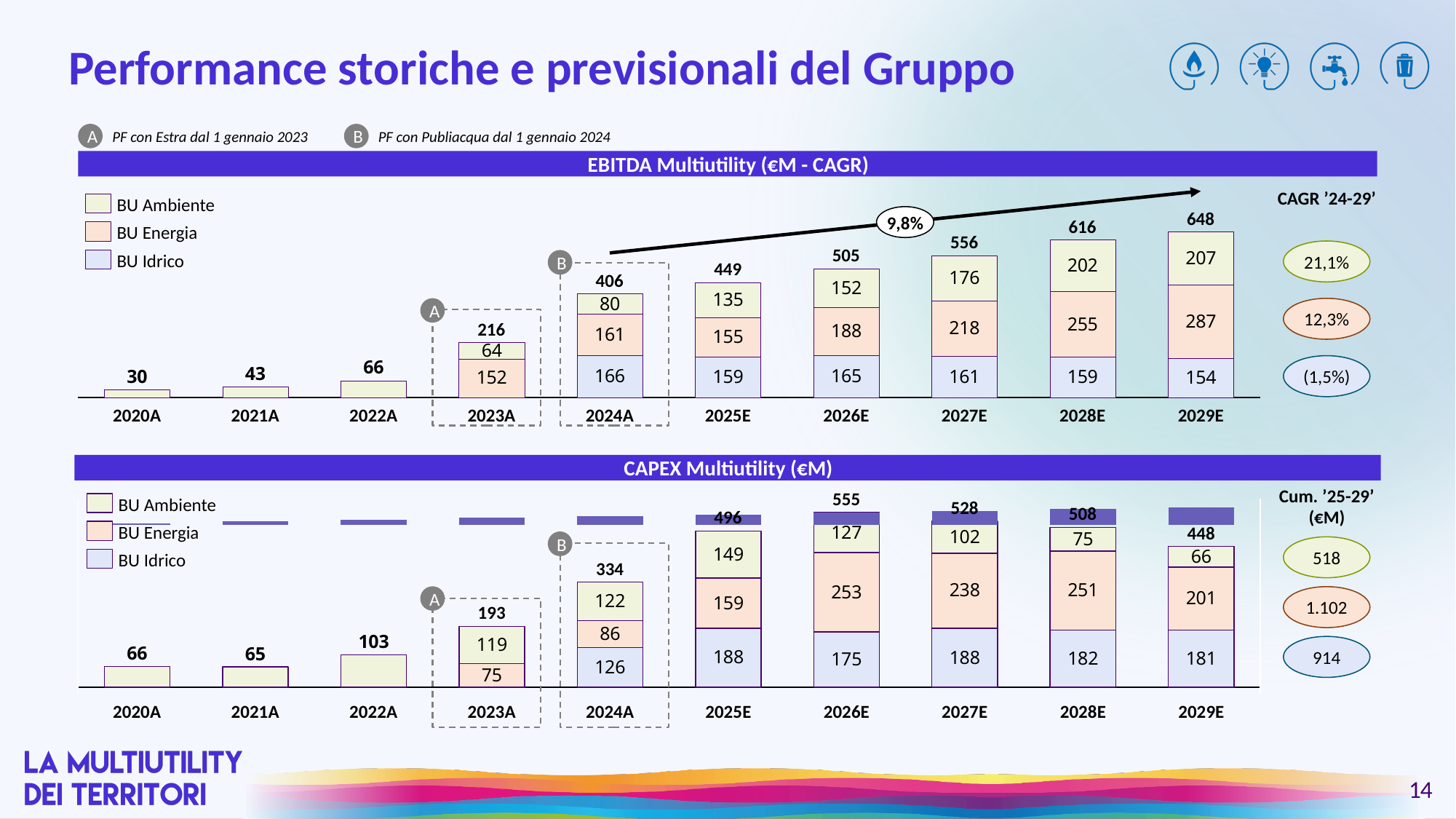
In the CAPEX Multiutility chart, what is the difference between the BU Energia values for 2028E and 2029E? 50 In the CAPEX Multiutility chart, which year has the highest total CAPEX? 2026E In the EBITDA Multiutility chart, what is the difference between the total EBITDA for 2024A and 2023A? 190 What kind of chart is the CAPEX Multiutility chart? Stacked bar chart In the EBITDA Multiutility chart, what is the BU Energia value for 2027E? 218 In the EBITDA Multiutility chart, what CAGR '24-29' is shown for the group total? 9,8% In the CAPEX Multiutility chart, what is the BU Idrico value for 2025E? 188 How many series does the legend of the EBITDA Multiutility chart list? 3 In the EBITDA Multiutility chart, what is the total EBITDA for 2029E? 648 In the EBITDA Multiutility chart, which year has the lowest total EBITDA? 2020A In the CAPEX Multiutility chart, what is the total CAPEX for 2026E? 555 In the EBITDA Multiutility chart, which is larger in 2026E: BU Energia or BU Idrico? BU Energia